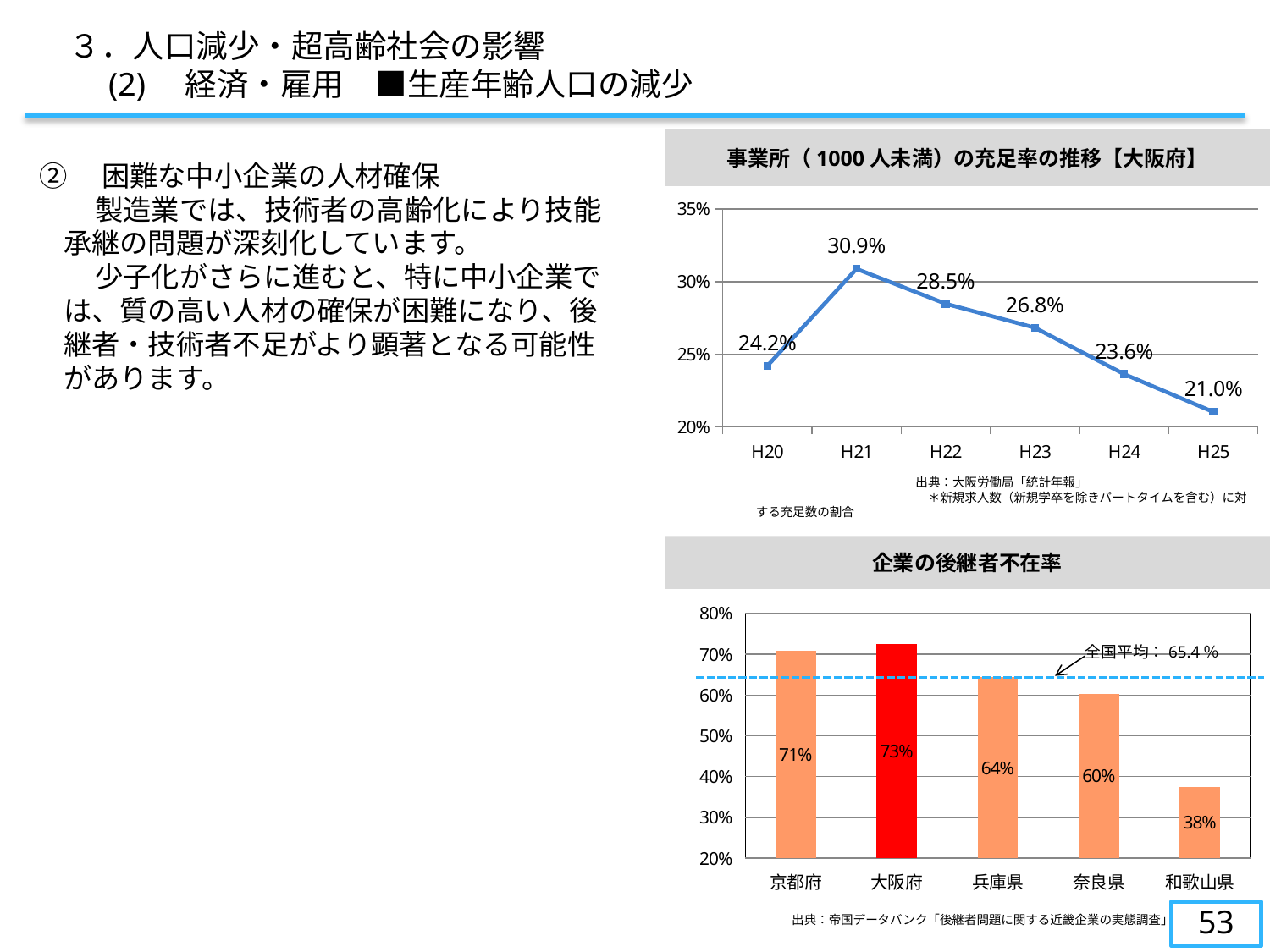
In the top chart (事業所（1000人未満）の充足率の推移【大阪府】), which year has the highest value? H21 What kind of chart is the top chart (事業所（1000人未満）の充足率の推移【大阪府】)? line chart In the top chart (事業所（1000人未満）の充足率の推移【大阪府】), which year has the lowest value? H25 In the top chart (事業所（1000人未満）の充足率の推移【大阪府】), what is the value for H21? 30.9% In the top chart (事業所（1000人未満）の充足率の推移【大阪府】), do the values rise or fall from H21 to H25? fall In the top chart (事業所（1000人未満）の充足率の推移【大阪府】), how many data points are plotted? 6 In the top chart (事業所（1000人未満）の充足率の推移【大阪府】), what is the value for H25? 21.0% In the bottom chart (企業の後継者不在率), what is the national average (全国平均) shown by the dashed line? 65.4% In the bottom chart (企業の後継者不在率), which is larger, the value for 京都府 or 兵庫県? 京都府 In the top chart (事業所（1000人未満）の充足率の推移【大阪府】), what is the difference between the H21 and H22 values? 2.4% In the bottom chart (企業の後継者不在率), which prefecture has the lowest value? 和歌山県 In the bottom chart (企業の後継者不在率), what is the value for 大阪府? 73%